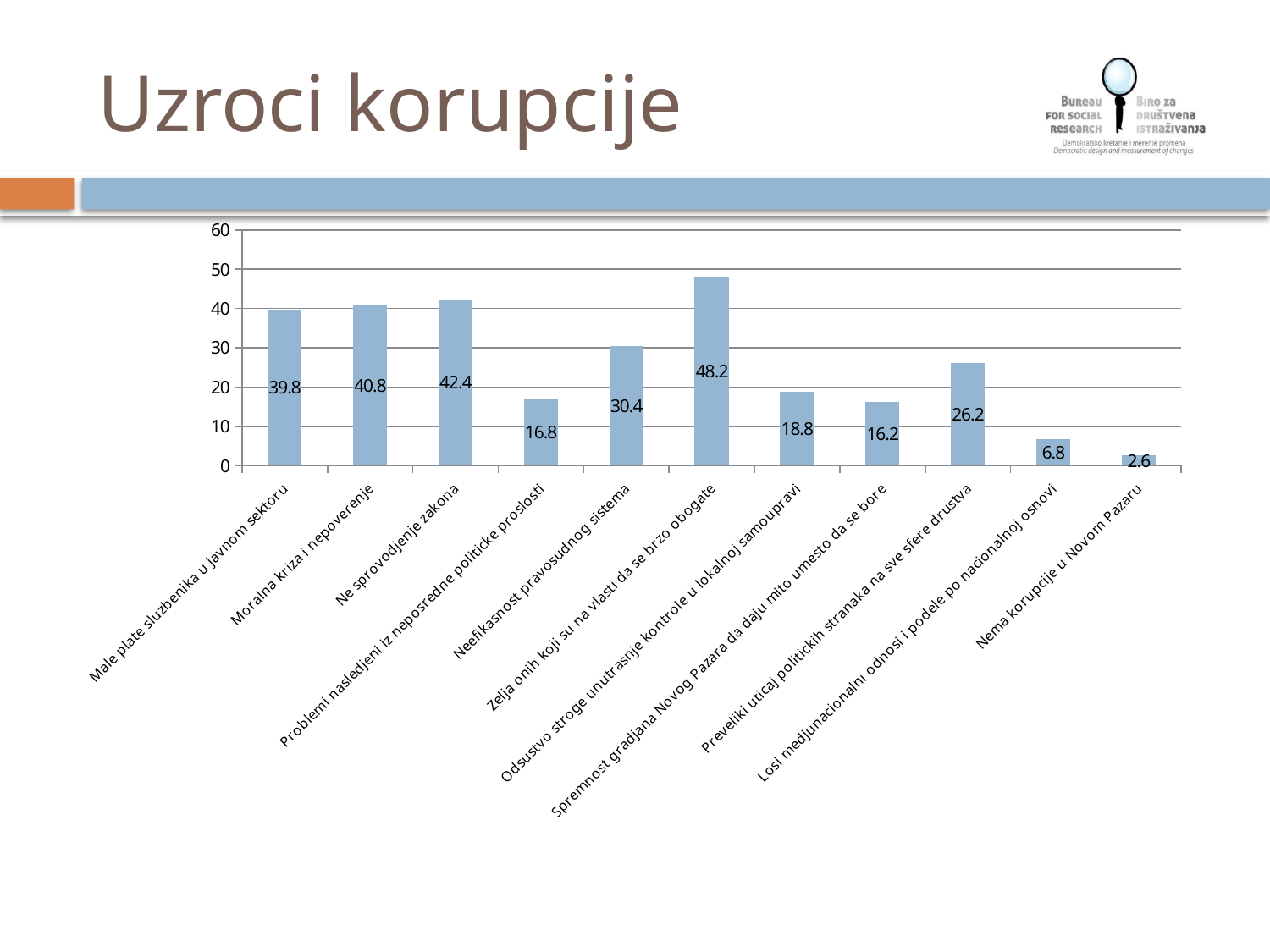
Which category has the lowest value? Nema korupcije u Novom Pazaru What is the value for "Losi medjunacionalni odnosi i podele po nacionalnoj osnovi"? 6.8 Is the value for "Moralna kriza i nepoverenje" greater or less than 30? greater What is the difference between the values for "Zelja onih koji su na vlasti da se brzo obogate" and "Nema korupcije u Novom Pazaru"? 45.6 What is the value for "Neefikasnost pravosudnog sistema"? 30.4 What is the value for "Zelja onih koji su na vlasti da se brzo obogate"? 48.2 How many categories are shown in the chart? 11 Which is larger: the value for "Preveliki uticaj politickih stranaka na sve sfere drustva" or the value for "Odsustvo stroge unutrasnje kontrole u lokalnoj samoupravi"? Preveliki uticaj politickih stranaka na sve sfere drustva Which category has the highest value? Zelja onih koji su na vlasti da se brzo obogate What is the title of the slide containing the chart? Uzroci korupcije What is the difference between the values for "Ne sprovodjenje zakona" and "Male plate sluzbenika u javnom sektoru"? 2.6 What kind of chart is shown on the slide? bar chart